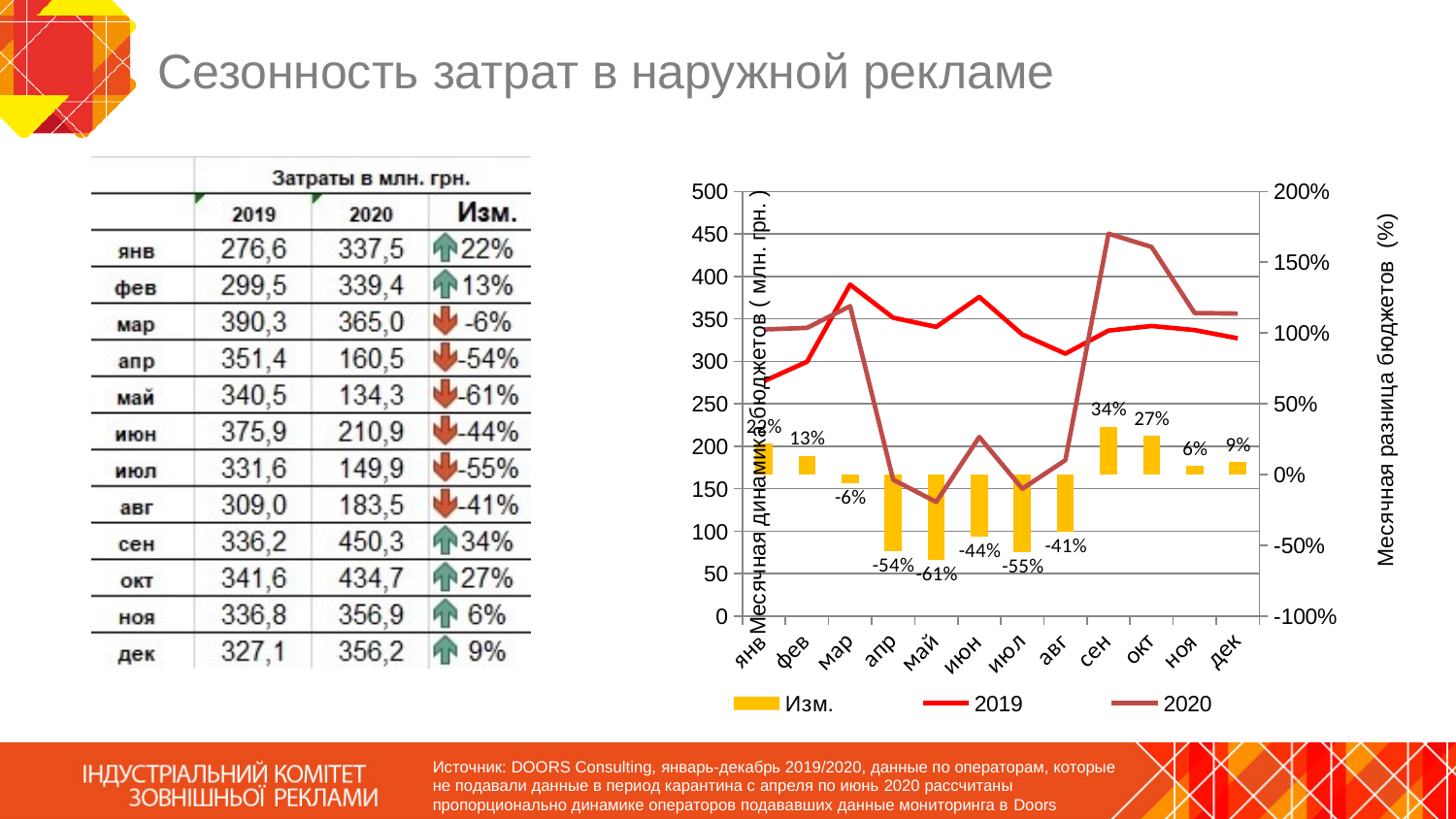
What is the Изм. value shown for май in the chart? -61% What is the Изм. value shown for сен in the chart? 34% Which month has the highest Изм. value in the chart? сен How many series does the chart legend list? 3 Which month has the lowest Изм. value in the chart? май How many months are shown on the x axis of the chart? 12 Is the 2020 line value for май greater or less than 150? less Is the 2020 line value for сен greater or less than 400? greater What is the difference between the Изм. values for сен and окт? 7 percentage points Which is larger, the Изм. value for апр or for авг? авг What kind of chart is shown on the slide? A combined bar and line chart Does the 2020 line rise or fall from авг to сен? rises